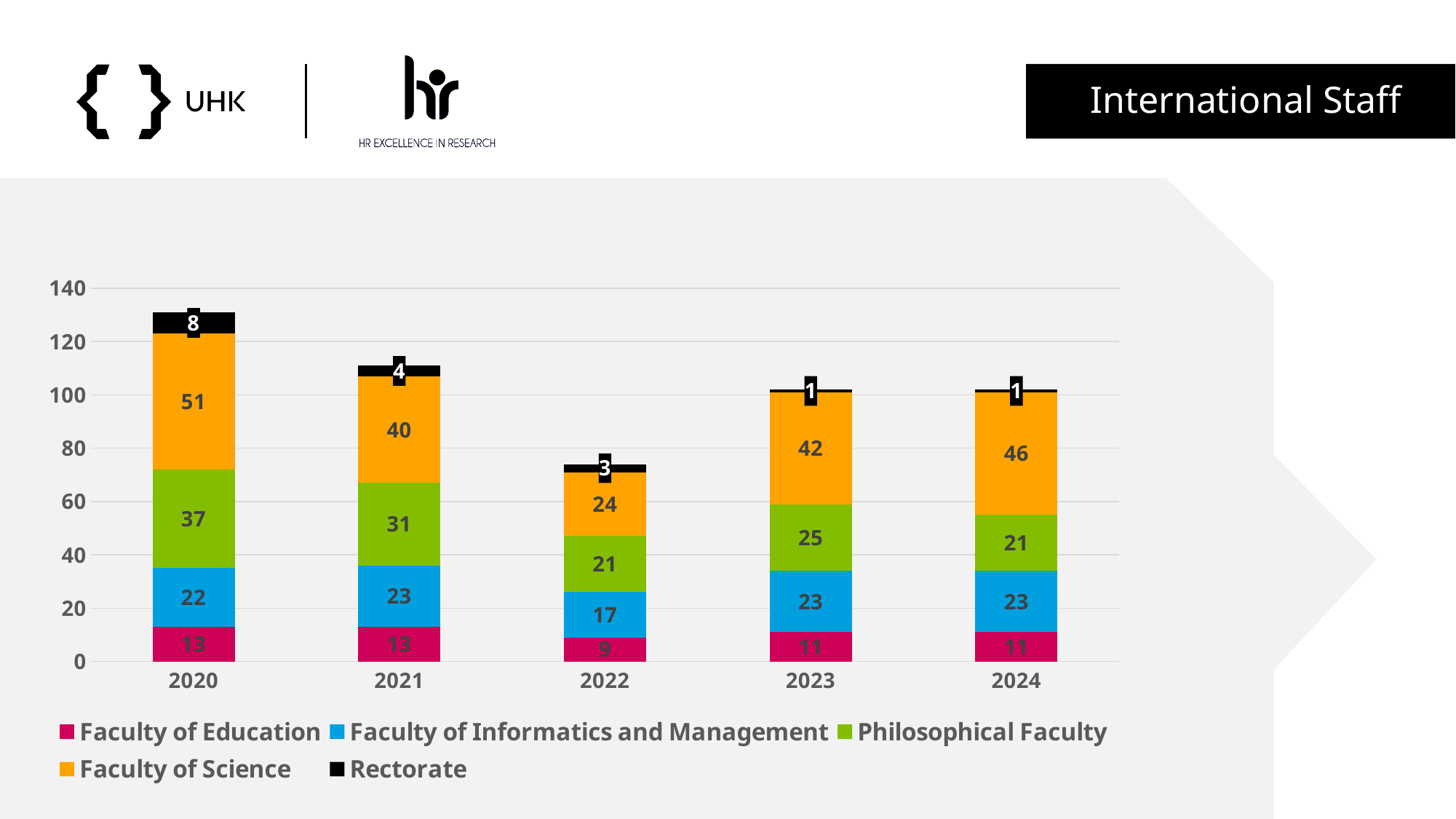
What type of chart is shown on the slide? Stacked bar chart What is the value for Rectorate in 2021? 4 In which year is the Faculty of Education value lowest? 2022 How many years are shown on the x axis? 5 What is the value for Faculty of Science in 2020? 51 How many series does the legend list? 5 What is the difference between the Faculty of Science values in 2024 and 2023? 4 In which year is the Faculty of Science value highest? 2020 Which series is shown in black in the legend? Rectorate Which is larger: Philosophical Faculty in 2021 or Philosophical Faculty in 2023? Philosophical Faculty in 2021 What is the value for Philosophical Faculty in 2022? 21 What is the total of the stacked bar for 2022? 74